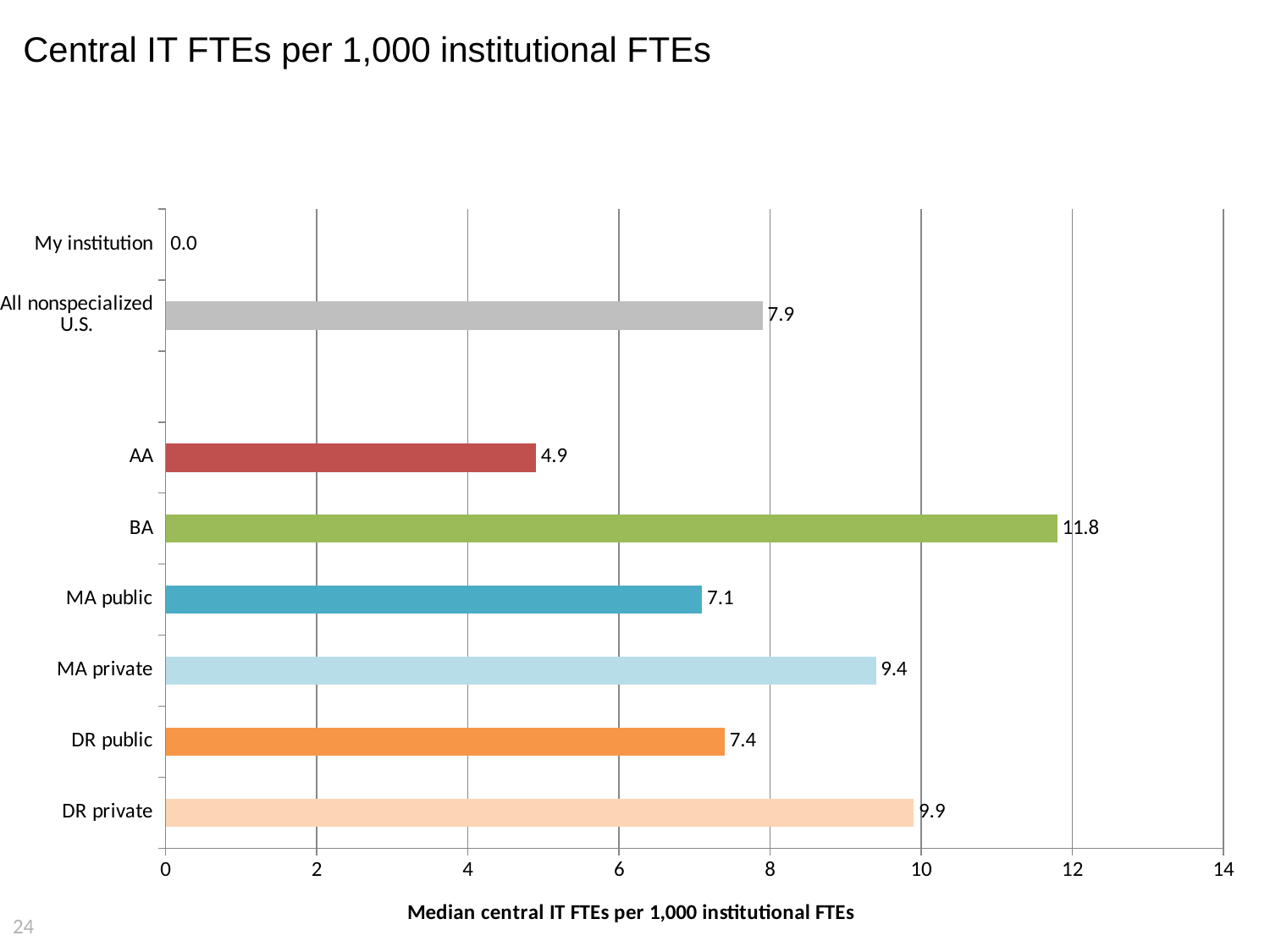
What is the x-axis title of the chart? Median central IT FTEs per 1,000 institutional FTEs Which is larger, the value for DR private or the value for DR public? DR private Is the value for AA greater or less than 6? less What is the value for DR public? 7.4 What is the difference between the values for BA and AA? 6.9 How many categories are shown on the chart? 8 Which category has the lowest value? My institution What kind of chart is shown on the slide? bar chart What is the value for All nonspecialized U.S.? 7.9 What is the difference between the values for MA private and MA public? 2.3 Which category has the highest value? BA What is the value for BA? 11.8